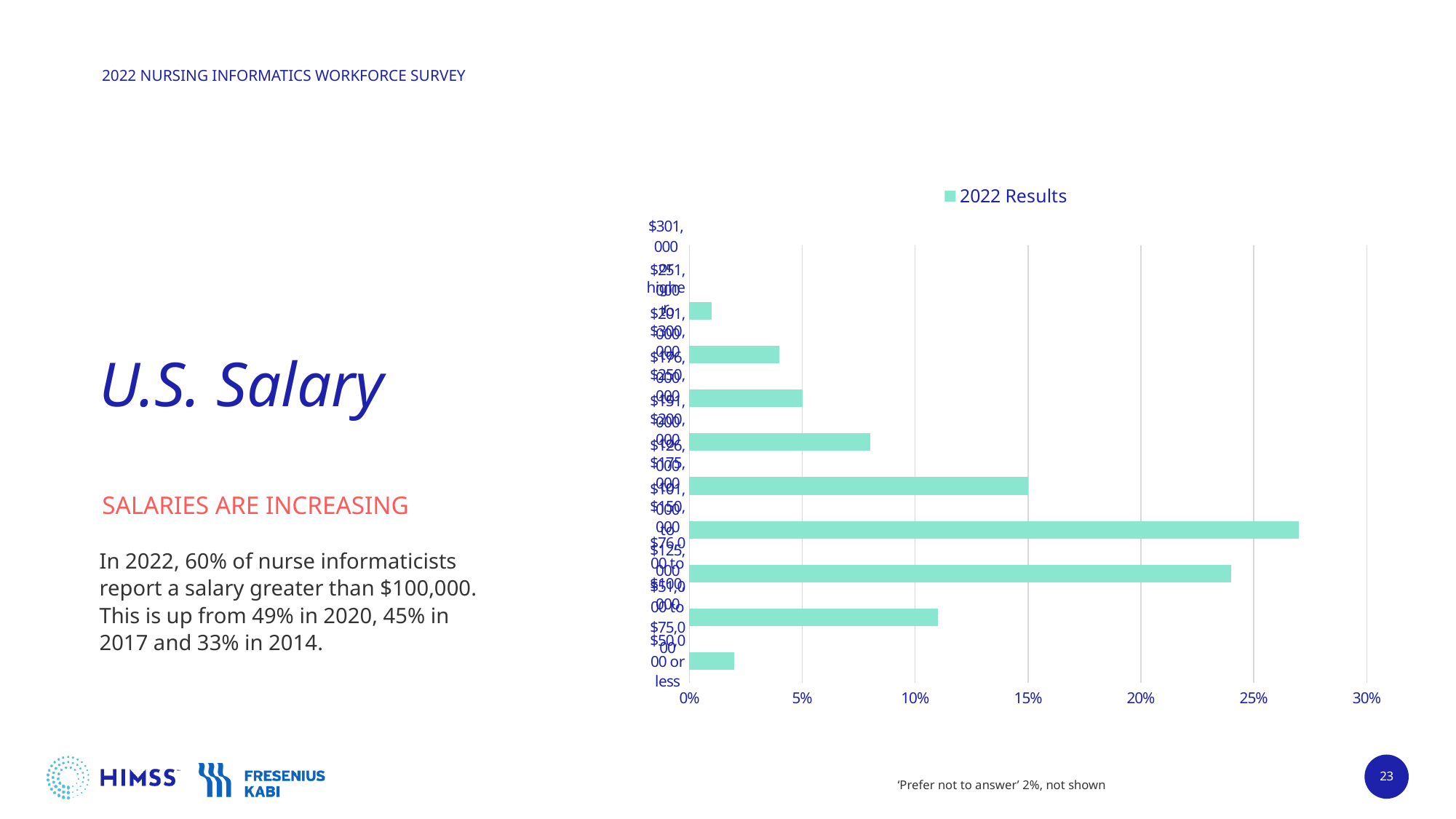
Is the value of the longest bar in the chart greater or less than 25%? greater What is the highest value labelled on the chart's horizontal axis? 30% How many bars are plotted in the chart? 9 How many series does the chart legend list? 1 Is the value for the "$50,000 or less" category greater or less than 5%? less What is the name of the series shown in the chart legend? 2022 Results What kind of chart is shown on the slide? bar chart Is the value of the shortest bar in the chart greater or less than 5%? less